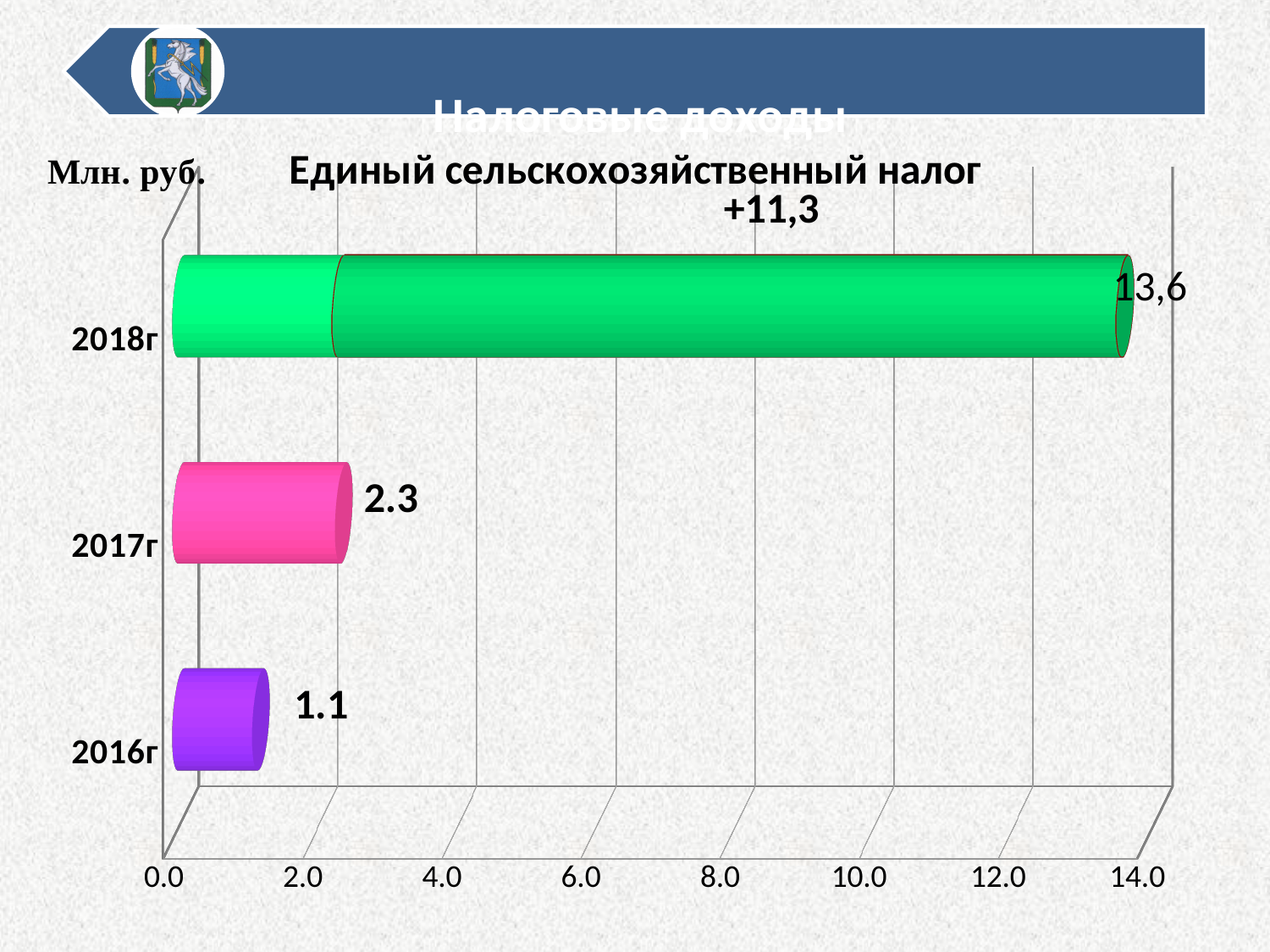
Which is larger, the value for 2017г or the value for 2016г? 2017г What is the value for 2016г in the chart? 1.1 What is the value for 2018г in the chart? 13,6 How many years are shown in the chart? 3 What kind of chart is shown on the slide? bar chart What is the title of the chart? Единый сельскохозяйственный налог Is the value for 2018г greater or less than 12.0? greater Which year has the highest value in the chart? 2018г What is the difference between the values for 2017г and 2016г? 1.2 What is the value for 2017г in the chart? 2.3 Which year has the lowest value in the chart? 2016г By how much does the value for 2018г exceed the value for 2017г? 11,3